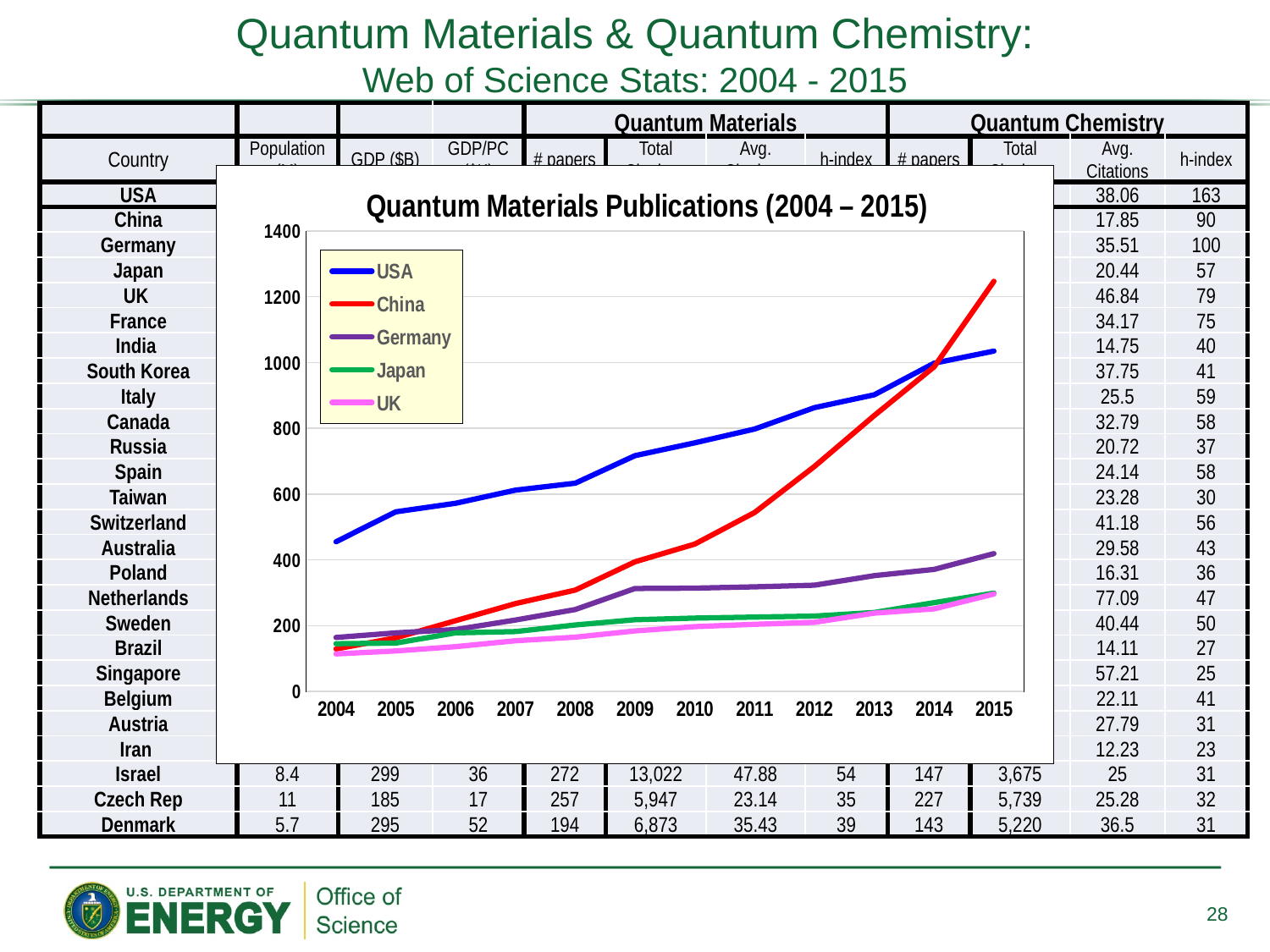
Which country has the highest number of Quantum Materials publications in 2015? China Is the value for USA in 2004 greater or less than 400? greater Is the value for UK in 2004 greater or less than 200? less How many series does the legend of the Quantum Materials Publications chart list? 5 Which country has the highest number of Quantum Materials publications in 2004? USA What is the title of the chart? Quantum Materials Publications (2004 – 2015) In 2010, which has more publications, USA or China? USA Is the value for China in 2012 greater or less than 600? greater What kind of chart is shown on the slide? line chart How many years are plotted along the x axis of the Quantum Materials Publications chart? 12 Does the USA line rise or fall from 2004 to 2015? rise